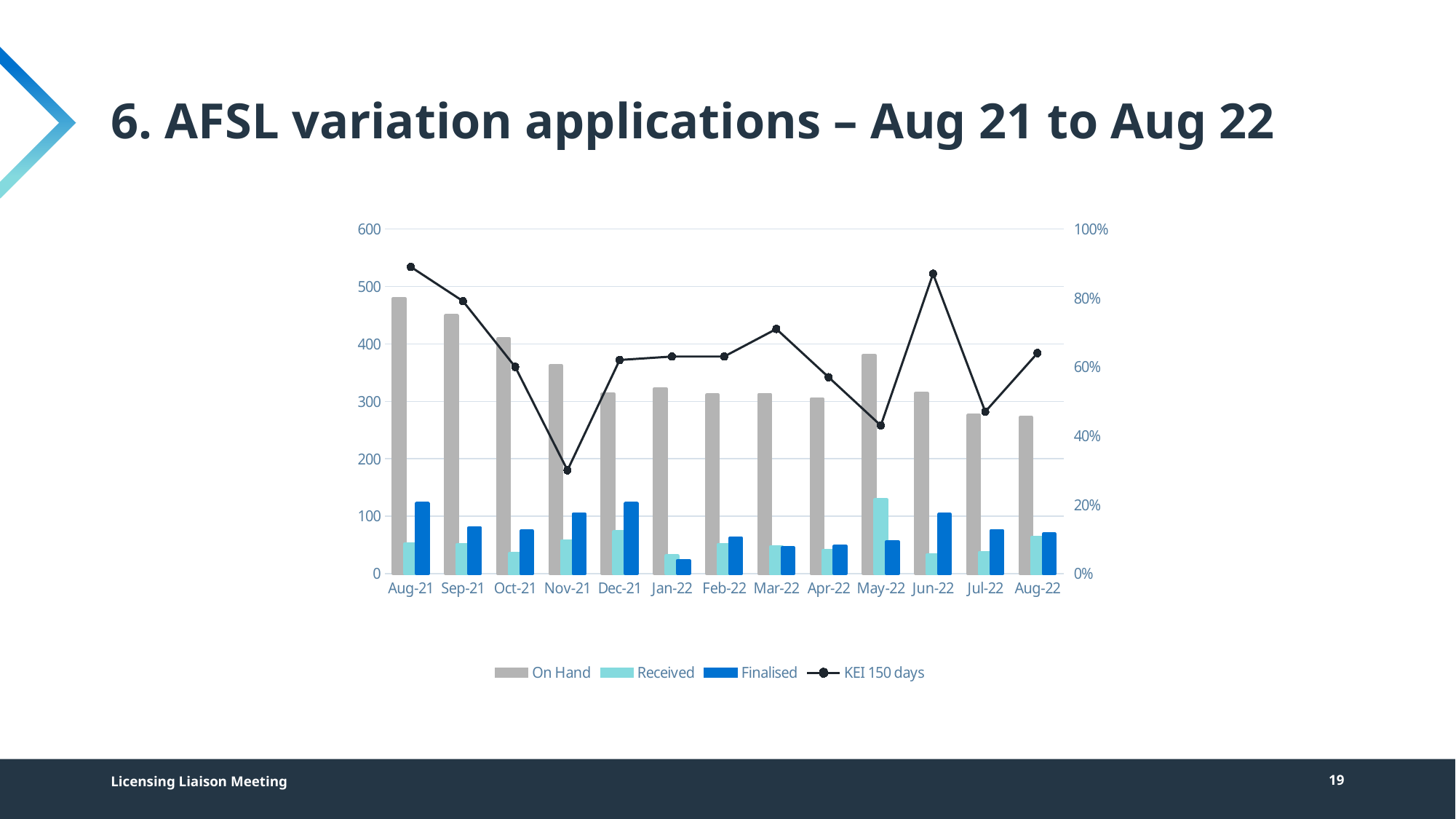
Which month has the lowest KEI 150 days value? Nov-21 Which month has the lowest Finalised value? Jan-22 Which is larger, the Finalised value for Aug-21 or for Jan-22? Aug-21 How many months are shown on the x axis of the chart? 13 Which month has the highest Received value? May-22 How many series does the chart legend list? 4 Does the On Hand value rise or fall from Aug-21 to Nov-21? fall Is the On Hand value for Aug-21 greater or less than 400? greater Is the KEI 150 days value for Nov-21 greater or less than 40%? less What kind of chart is shown on the slide? Combination bar and line chart Which month has the highest On Hand value? Aug-21 Is the Received value for May-22 greater or less than 100? greater